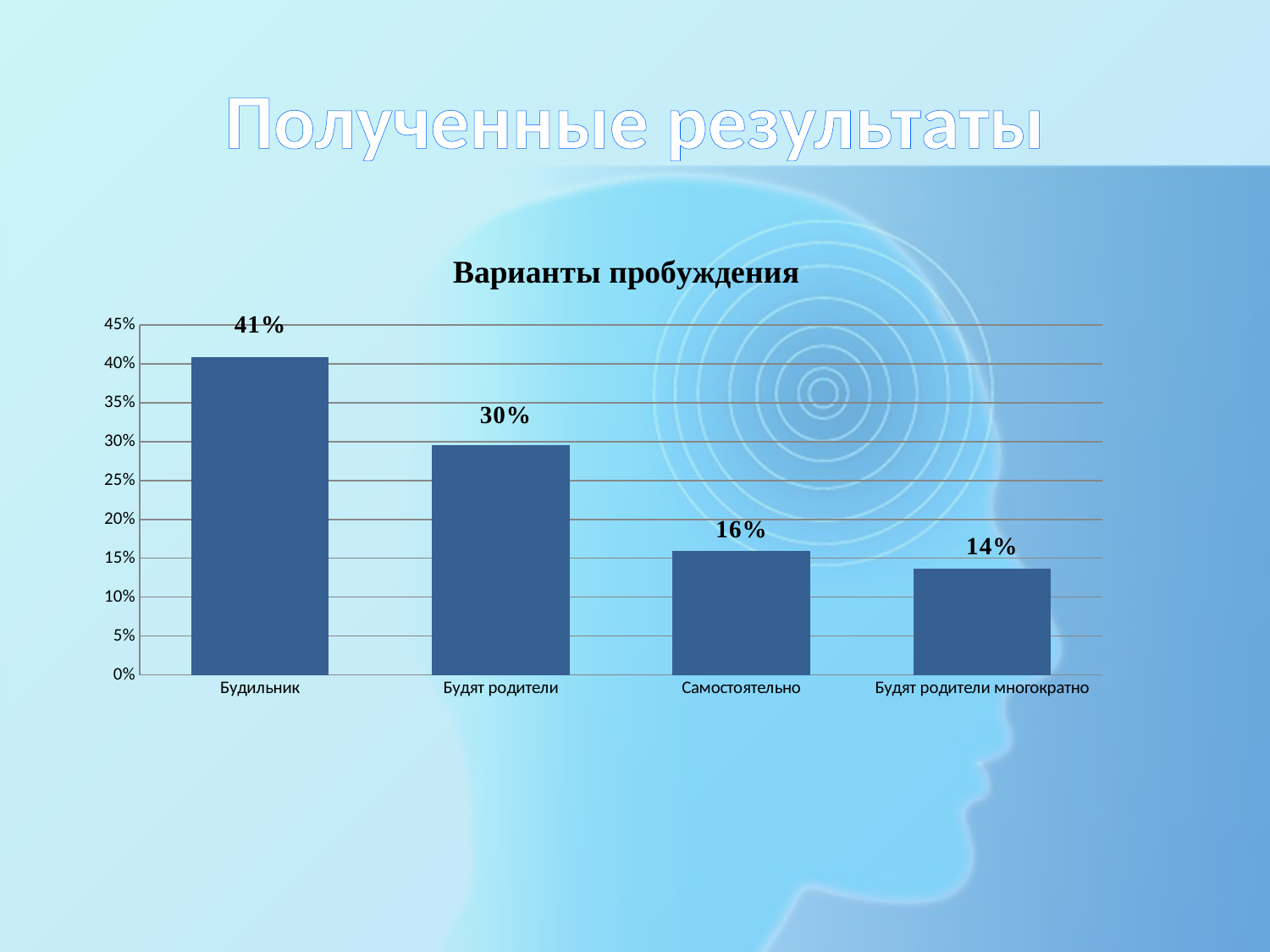
What is the value for Будят родители? 30% Which category has the highest value? Будильник Which category has the lowest value? Будят родители многократно What is the value for Самостоятельно? 16% What is the value for Будильник? 41% Which is larger, the value for Самостоятельно or the value for Будят родители многократно? Самостоятельно What is the value for Будят родители многократно? 14% What is the difference between the values for Будильник and Будят родители? 11% What kind of chart is shown on the slide? bar chart What is the title of the chart? Варианты пробуждения How many categories are shown on the chart? 4 Is the value for Будят родители greater or less than 25%? greater